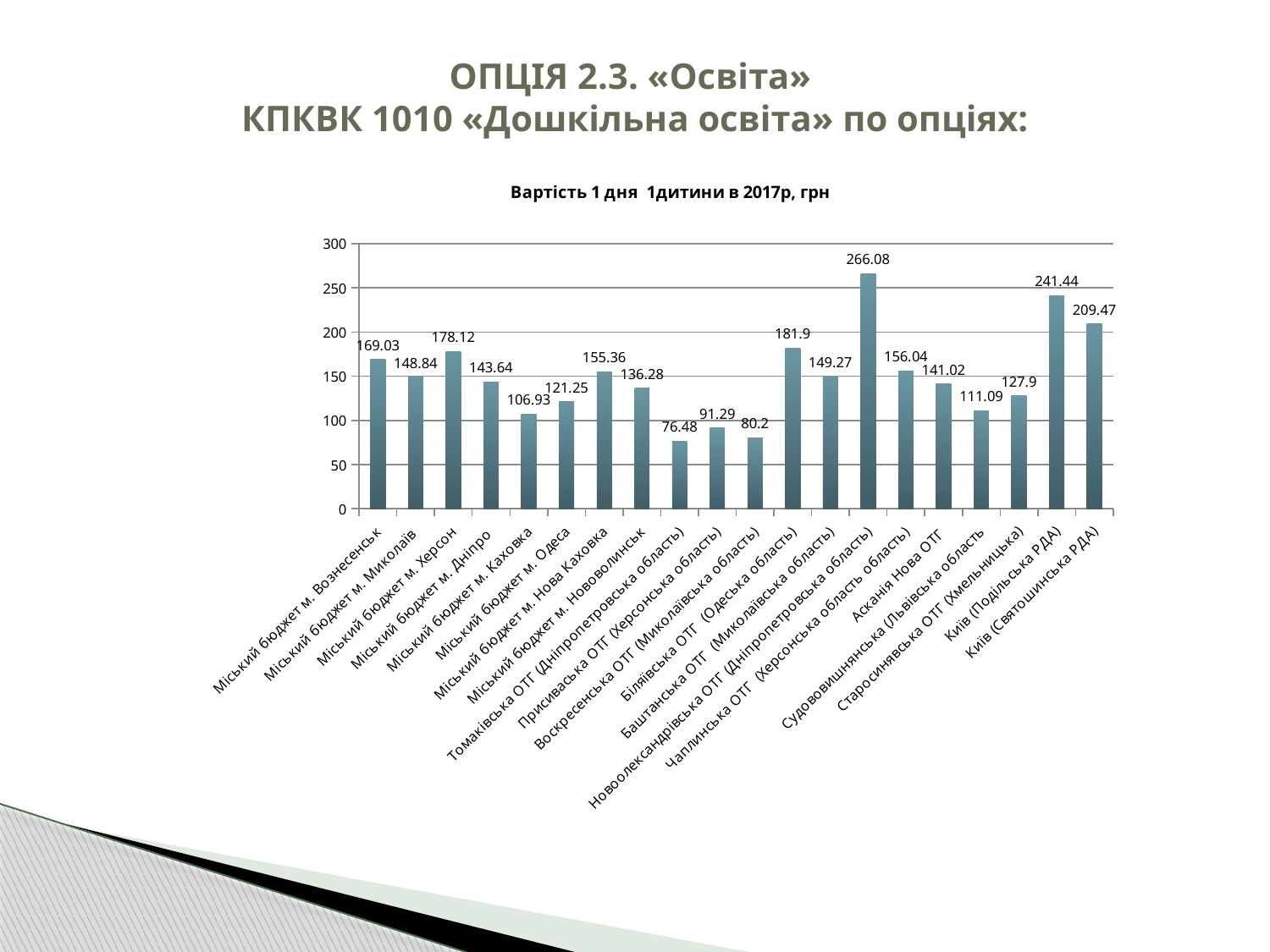
Which is larger: the value for Міський бюджет м. Одеса or Міський бюджет м. Нова Каховка? Міський бюджет м. Нова Каховка What is the title of the chart? Вартість 1 дня 1дитини в 2017р, грн What is the value for Київ (Подільська РДА)? 241.44 Which category has the highest value? Новоолександрівська ОТГ (Дніпропетровська область) What kind of chart is shown on the slide? bar chart What is the value for Томаківська ОТГ (Дніпропетровська область)? 76.48 Is the value for Біляївська ОТГ (Одеська область) greater or less than 150? greater How many categories are shown in the chart? 20 What is the value for Асканія Нова ОТГ? 141.02 Which category has the lowest value? Томаківська ОТГ (Дніпропетровська область) What is the value for Міський бюджет м. Херсон? 178.12 What is the difference between the values for Київ (Подільська РДА) and Київ (Святошинська РДА)? 31.97